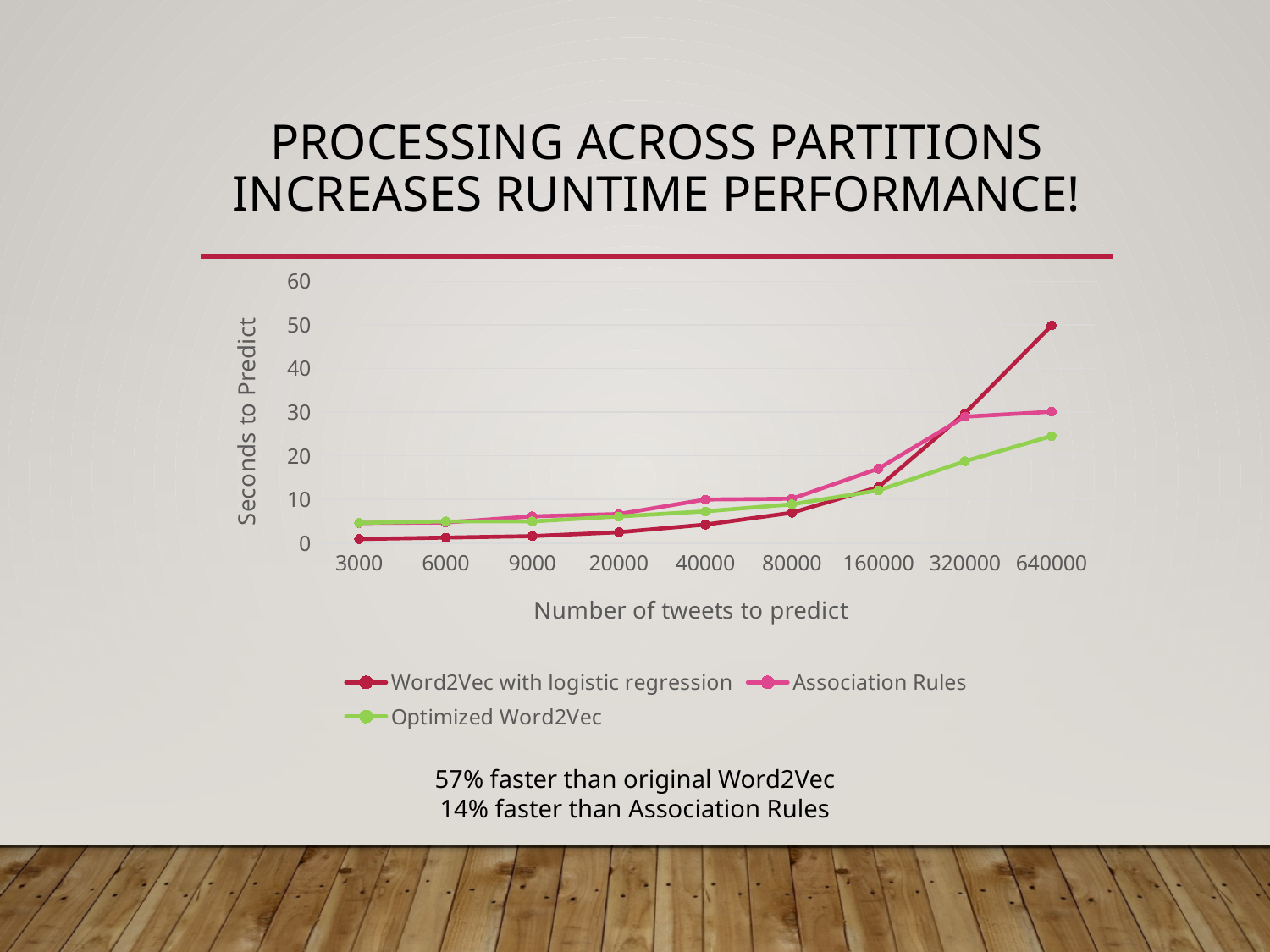
What is the label of the y axis? Seconds to Predict Do the values for Word2Vec with logistic regression rise or fall as the number of tweets increases? rise What is the label of the x axis? Number of tweets to predict How many series does the legend list? 3 Which series has the lowest value at 640000 tweets? Optimized Word2Vec How many values of 'Number of tweets to predict' are shown on the x axis? 9 Which series has the highest value at 640000 tweets? Word2Vec with logistic regression Is the value for Optimized Word2Vec at 640000 tweets greater or less than 30? less Is the value for Word2Vec with logistic regression at 640000 tweets greater or less than 40? greater At 640000 tweets, which is larger: Association Rules or Optimized Word2Vec? Association Rules What kind of chart is shown on the slide? line chart Is the value for Association Rules at 160000 tweets greater or less than 10? greater